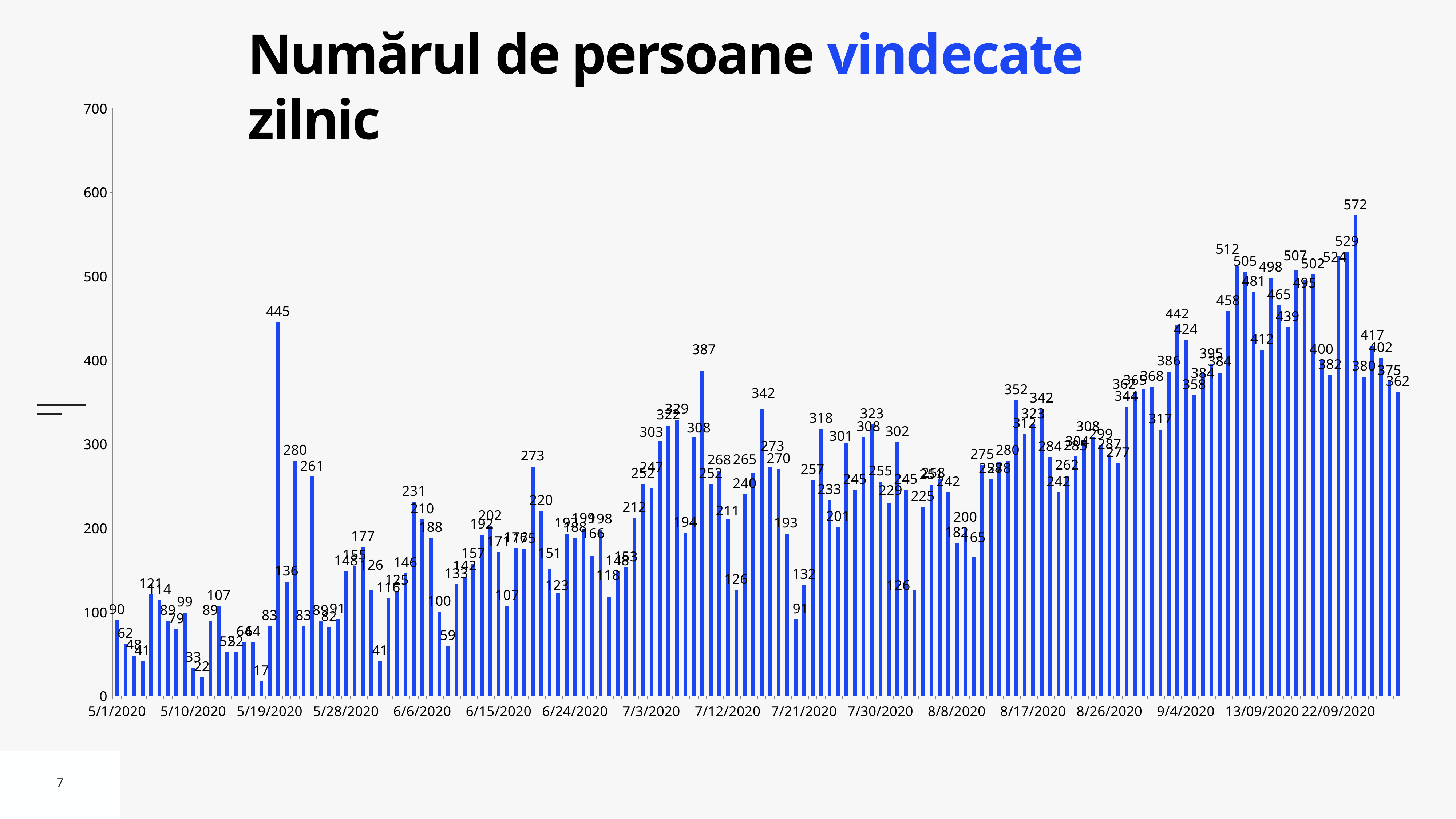
What is the difference between the highest value (572) and the lowest value (17) in the chart? 555 What is the value for 7/3/2020? 247 What kind of chart is shown on the slide? bar chart What is the value for 9/4/2020? 424 What is the highest value shown in the chart? 572 Which is larger, the peak value in May (445) or the peak value in July (387)? 445 What is the maximum value shown on the vertical axis? 700 What is the value for 5/1/2020? 90 What is the lowest value shown in the chart? 17 Overall, do the values rise or fall from May 2020 to September 2020? rise What is the title of the chart? Numărul de persoane vindecate zilnic Is the value for 5/1/2020 greater or less than 100? less